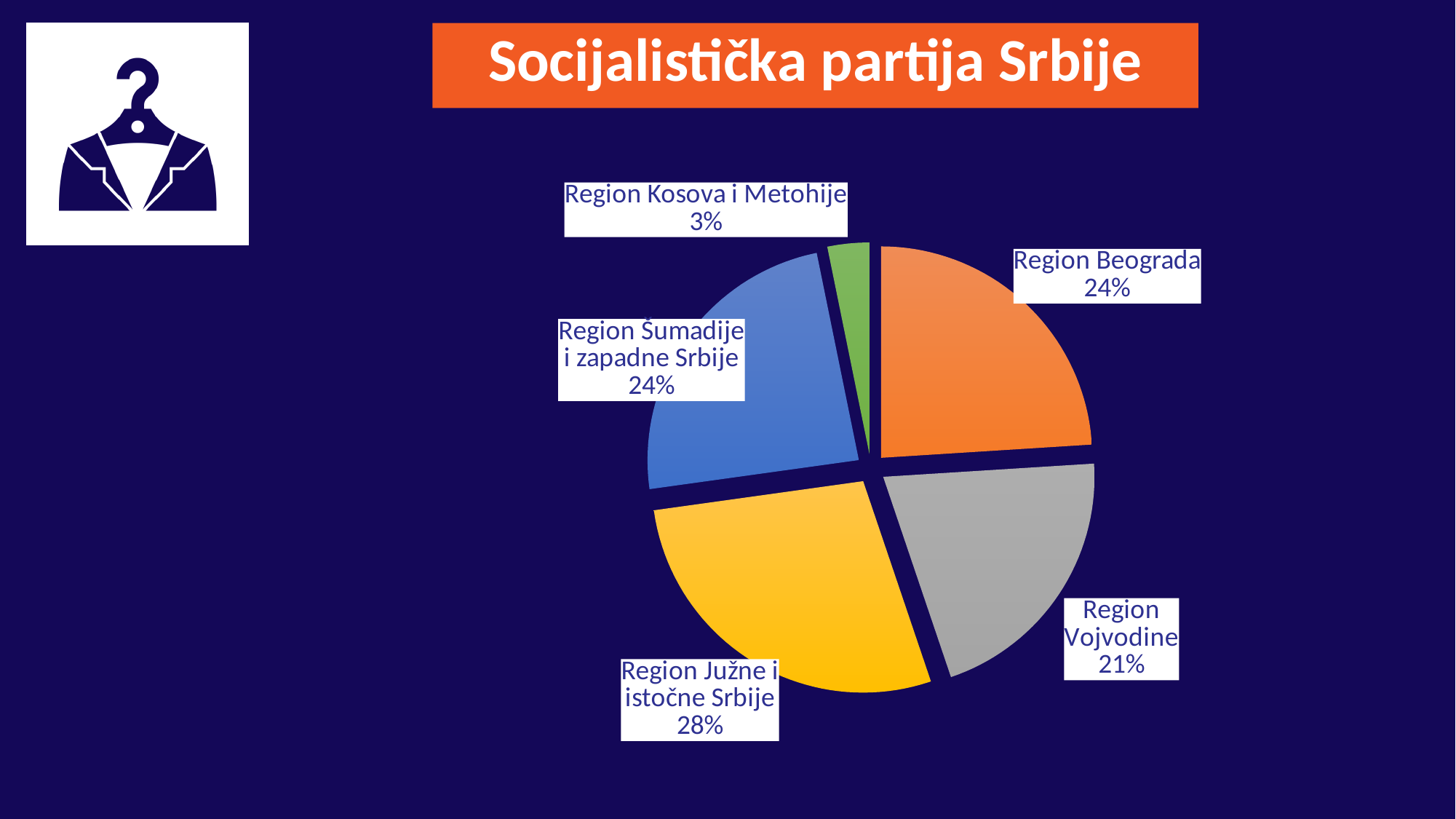
What share of the pie does Region Vojvodine have? 21% What is the difference in percentage points between Region Južne i istočne Srbije and Region Vojvodine? 7 Which region has the smallest slice of the pie? Region Kosova i Metohije What kind of chart is shown on the slide? pie chart How many slices does the pie chart have? 5 What share of the pie does Region Južne i istočne Srbije have? 28% What share of the pie does Region Beograda have? 24% What is the title of the chart? Socijalistička partija Srbije Which region has the largest slice of the pie? Region Južne i istočne Srbije Which is larger, the share for Region Beograda or the share for Region Vojvodine? Region Beograda